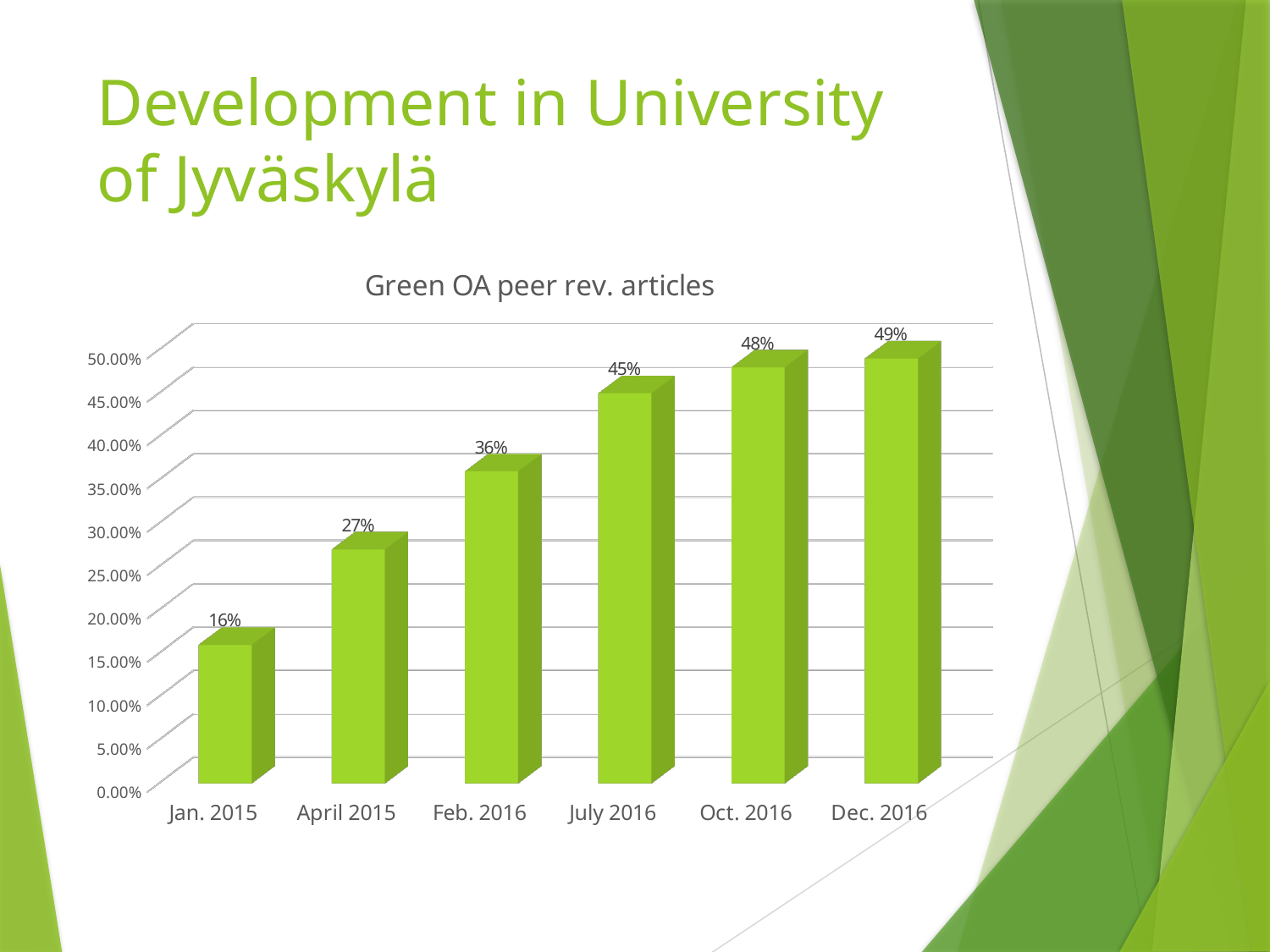
What is the value for Feb. 2016? 36% Do the values rise or fall from Jan. 2015 to Dec. 2016? rise How many periods are shown on the x axis? 6 What is the value for Jan. 2015? 16% Which period has the lowest value? Jan. 2015 What kind of chart is shown? bar chart Which period has the highest value? Dec. 2016 What is the difference between the values for July 2016 and April 2015? 18% Which is larger, the value for April 2015 or the value for Feb. 2016? Feb. 2016 What is the value for Oct. 2016? 48% What is the title of the chart? Green OA peer rev. articles What is the difference between the values for Dec. 2016 and Jan. 2015? 33%